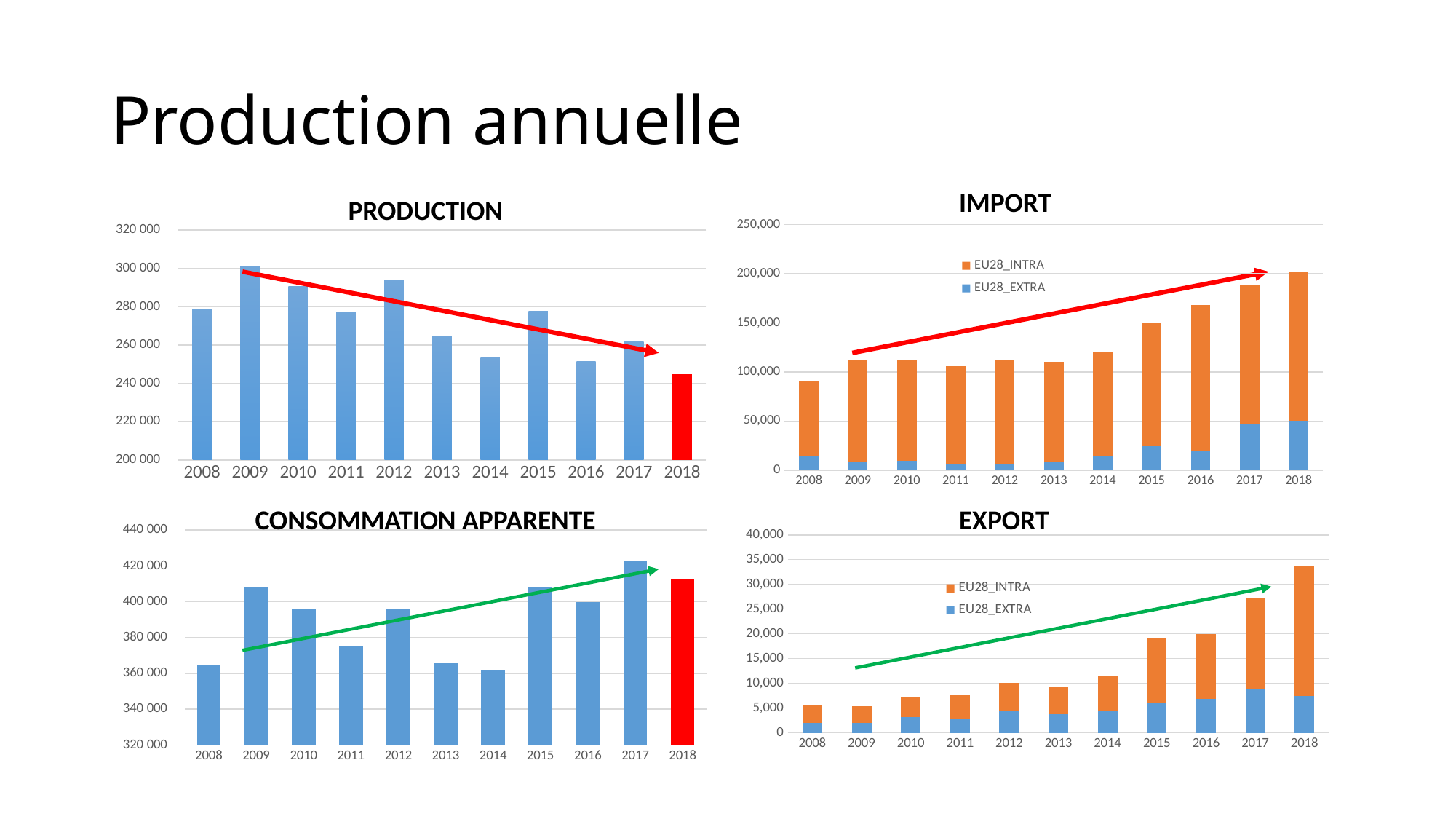
In the IMPORT chart, which year has the highest total import? 2018 In the PRODUCTION chart, which year has the lowest production? 2018 In the IMPORT chart, is the total for 2018 greater or less than 150,000? greater In the PRODUCTION chart, which year has the highest production? 2009 What kind of chart is the EXPORT chart? stacked bar chart In the IMPORT chart, do the total values generally rise or fall from 2008 to 2018? rise In the EXPORT chart, which year has the highest total export? 2018 In the CONSOMMATION APPARENTE chart, is the value for 2009 greater or less than 400 000? greater In the PRODUCTION chart, is the value for 2014 greater or less than 260 000? less In the PRODUCTION chart, how many years are shown on the x axis? 11 In the IMPORT chart, how many series does the legend list? 2